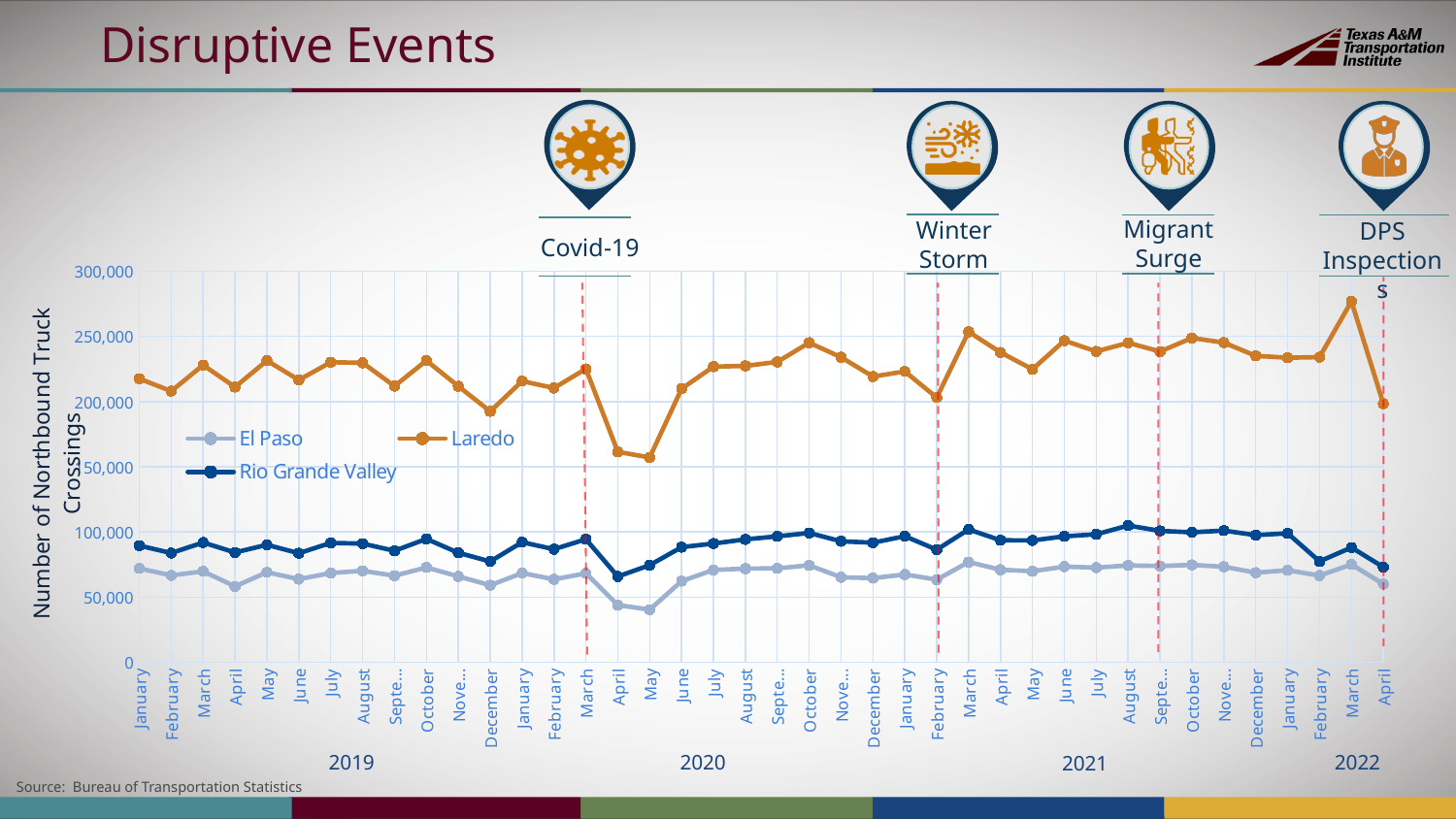
How many monthly data points are plotted for each series? 40 What is the title of the vertical axis? Number of Northbound Truck Crossings Is the value for Laredo in March 2022 greater or less than 250,000? greater Do the Laredo values rise or fall from February 2020 to May 2020? fall Is the value for El Paso in April 2020 greater or less than 50,000? less What kind of chart is shown on the slide? Line chart Which series has the highest number of northbound truck crossings throughout the chart? Laredo Is the value for Laredo in May 2020 greater or less than 200,000? less Which is larger in March 2021, the value for Rio Grande Valley or the value for El Paso? Rio Grande Valley In which month and year does the Laredo series reach its highest value? March 2022 How many series does the legend list? 3